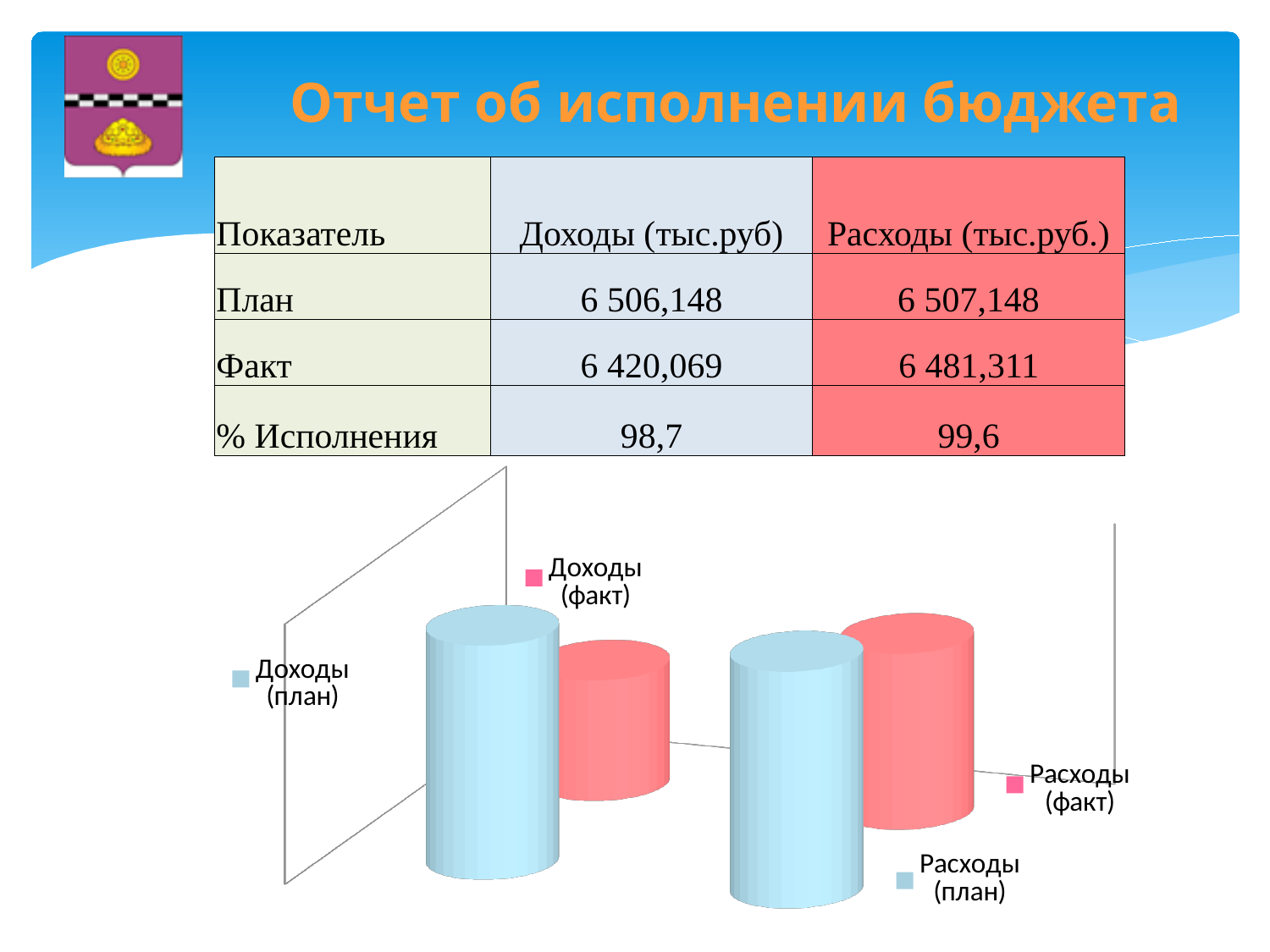
Which is larger in the chart, Доходы (план) or Доходы (факт)? Доходы (план) What colour is the bar for Доходы (факт) in the chart? pink What kind of chart is shown on the slide? bar chart How many bars (cylinders) are plotted in the chart? 4 What colour is the bar for Расходы (план) in the chart? light blue